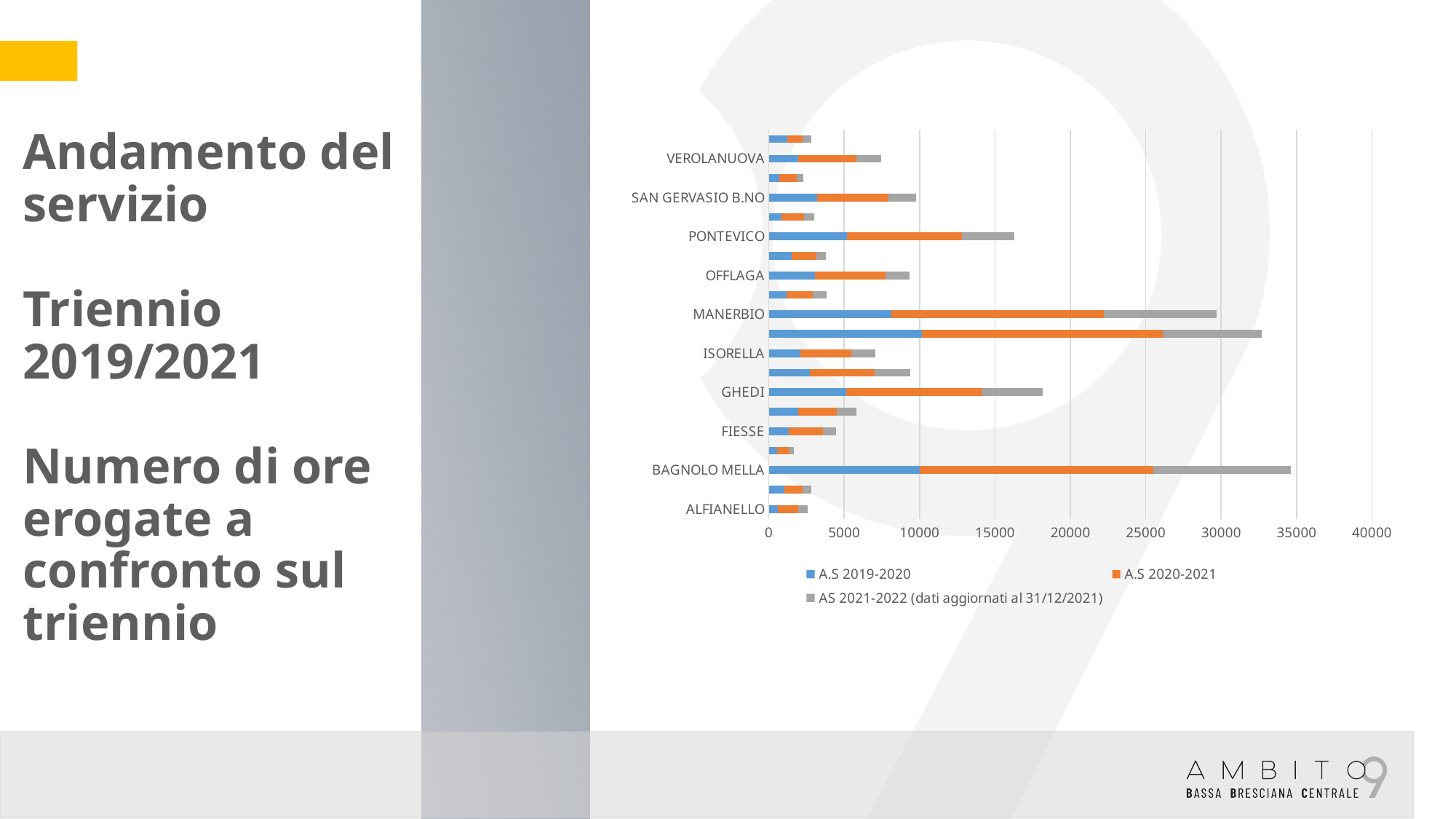
Among the labelled categories, which has the longest total bar? BAGNOLO MELLA Is the total bar for ALFIANELLO greater or less than 5000? less Which series is shown in blue in the chart? A.S 2019-2020 Which has the longer total bar, GHEDI or PONTEVICO? GHEDI Among the labelled categories, which has the shortest total bar? ALFIANELLO Is the total bar for FIESSE greater or less than 5000? less How many series does the chart legend list? 3 Is the total bar for BAGNOLO MELLA greater or less than 30000? greater What kind of chart is shown on the slide? bar chart Which has the longer total bar, OFFLAGA or FIESSE? OFFLAGA What is the highest value shown on the horizontal axis of the chart? 40000